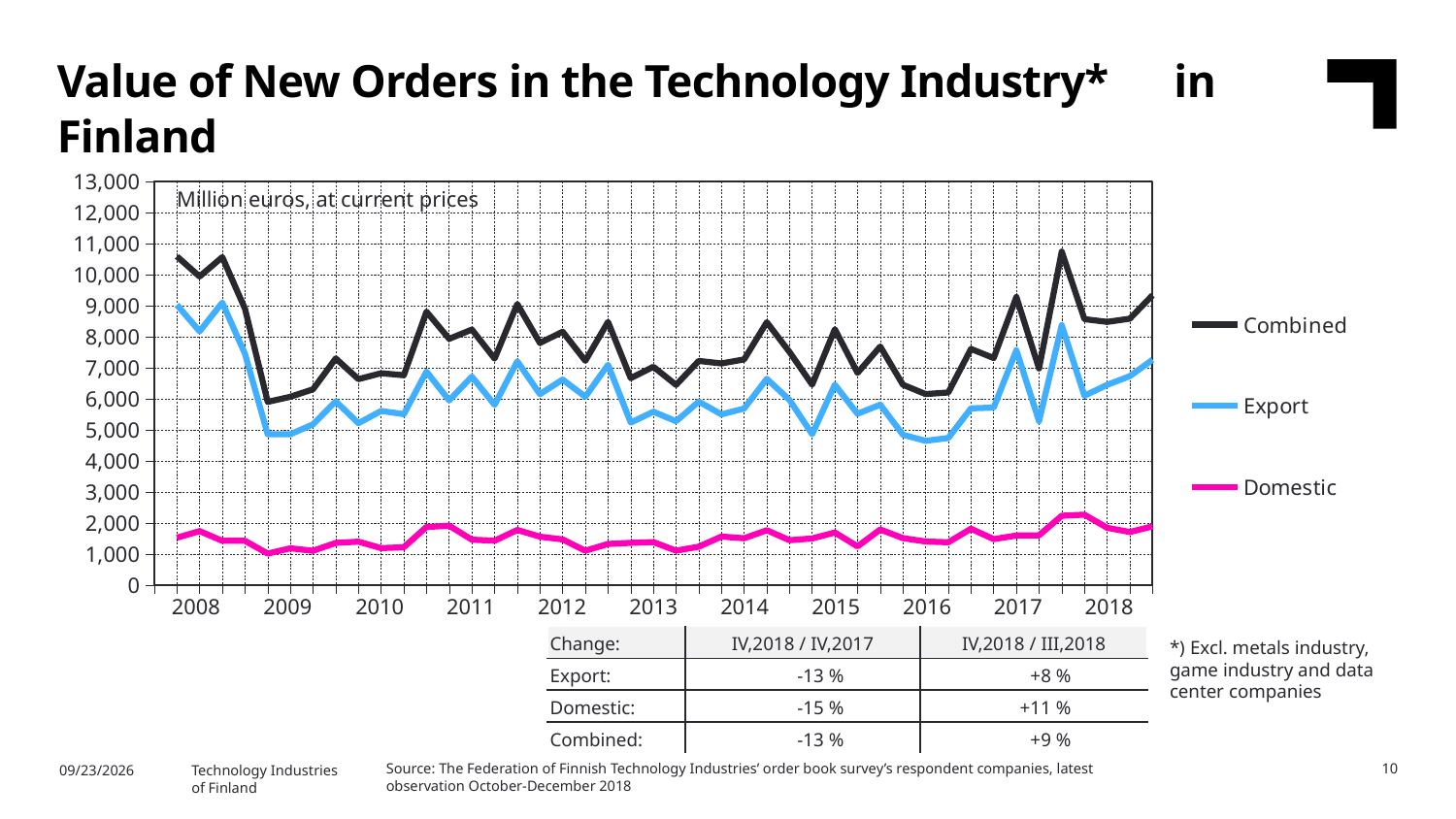
Does the Combined line rise or fall from 2008 to 2009? fall Which series is plotted with the highest values throughout the chart? Combined Which series is plotted with the lowest values throughout the chart? Domestic What kind of chart is shown on the slide? Line chart Is the Domestic value in 2018 greater or less than 3,000? less How many year labels are shown on the x axis? 11 Is the Export value in 2009 greater or less than 6,000? less Does the Export line rise or fall overall from 2016 to 2018? rise How many series does the legend list? 3 What unit is stated in the label inside the chart area? Million euros, at current prices In 2018, which series has the larger value, Export or Domestic? Export Is the Combined value at the start of 2008 greater or less than 9,000? greater